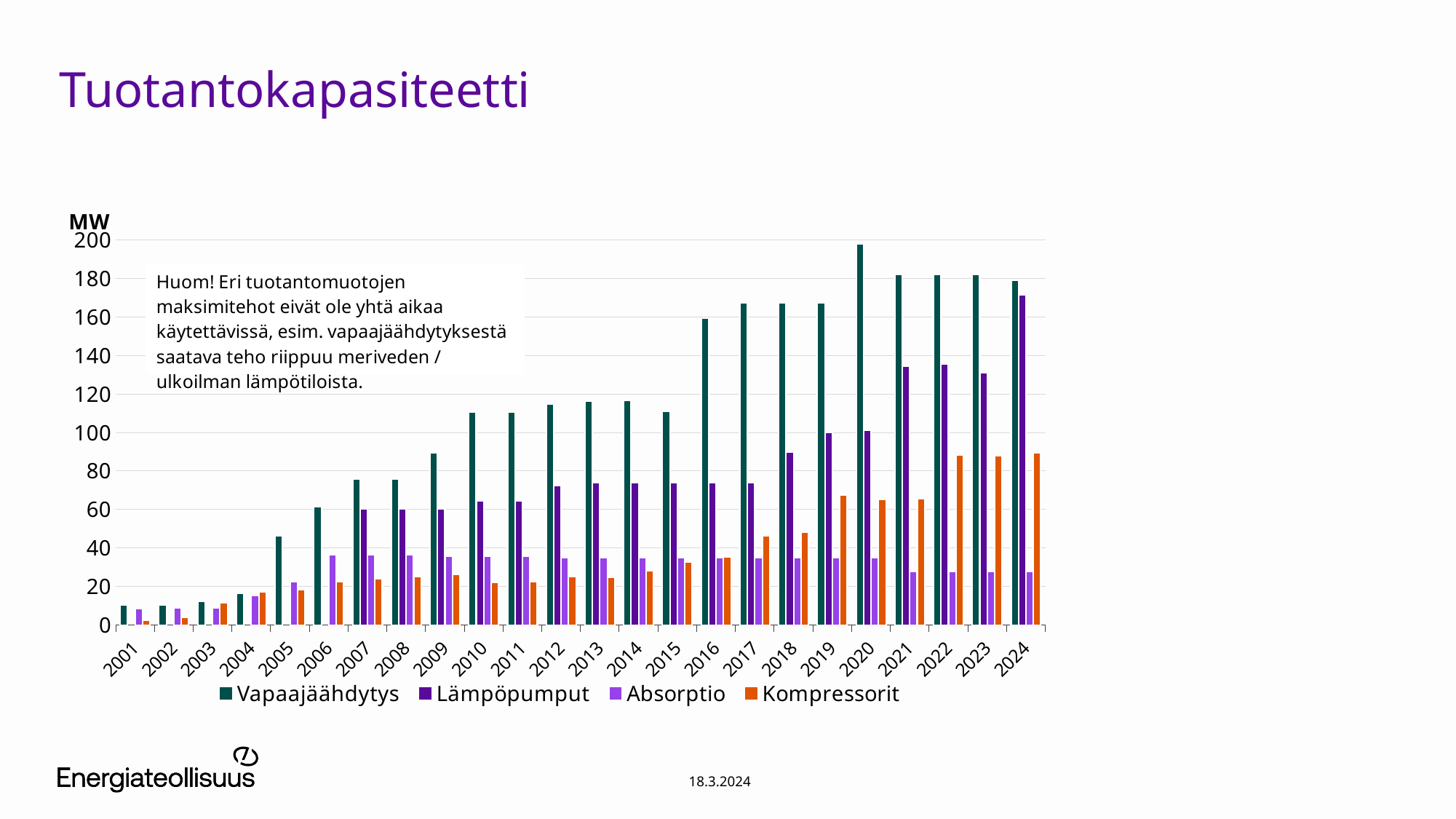
Which series has the lowest value in 2024? Absorptio Which is larger in 2024, Lämpöpumput or Kompressorit? Lämpöpumput How many years are shown on the x axis? 24 Is the value for Lämpöpumput in 2024 greater or less than 160? greater What kind of chart is shown on the slide? bar chart Is the value for Absorptio in 2024 greater or less than 40? less In which year is the Vapaajäähdytys value highest? 2020 How many series does the legend list? 4 Do the Lämpöpumput values generally rise or fall from 2001 to 2024? rise In which year is the Kompressorit value lowest? 2001 Is the value for Kompressorit in 2024 greater or less than 80? greater